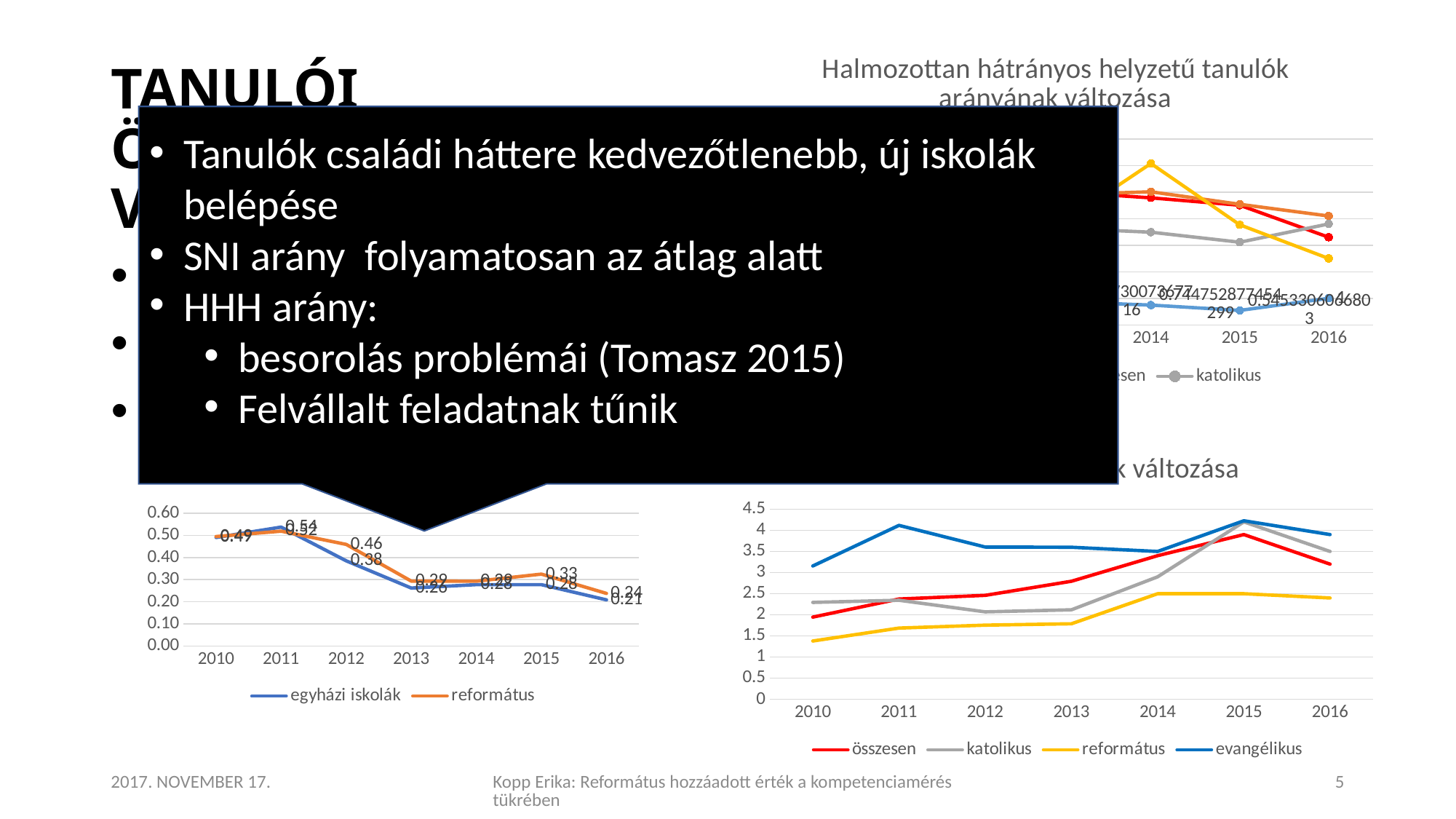
In the bottom-right chart, is the value for evangélikus in 2011 greater or less than 4? greater In the bottom-left chart, what is the value for református in 2015? 0.33 In the bottom-left chart, which series has the larger value in 2012, egyházi iskolák or református? református In the bottom-left chart, in which year is the egyházi iskolák series at its highest? 2011 In the bottom-left chart, what is the difference between református and egyházi iskolák in 2015? 0.05 In the bottom-left chart, in which year is the református series at its lowest? 2016 In the bottom-left chart, what is the value for egyházi iskolák in 2011? 0.54 In the bottom-right chart, is the value for református in 2010 greater or less than 1.5? less In the bottom-right chart, which series has the lowest value in 2010? református How many series does the legend of the bottom-right chart list? 4 In the bottom-left chart, does the egyházi iskolák series rise or fall overall from 2010 to 2016? fall What kind of chart is the bottom-right chart? line chart